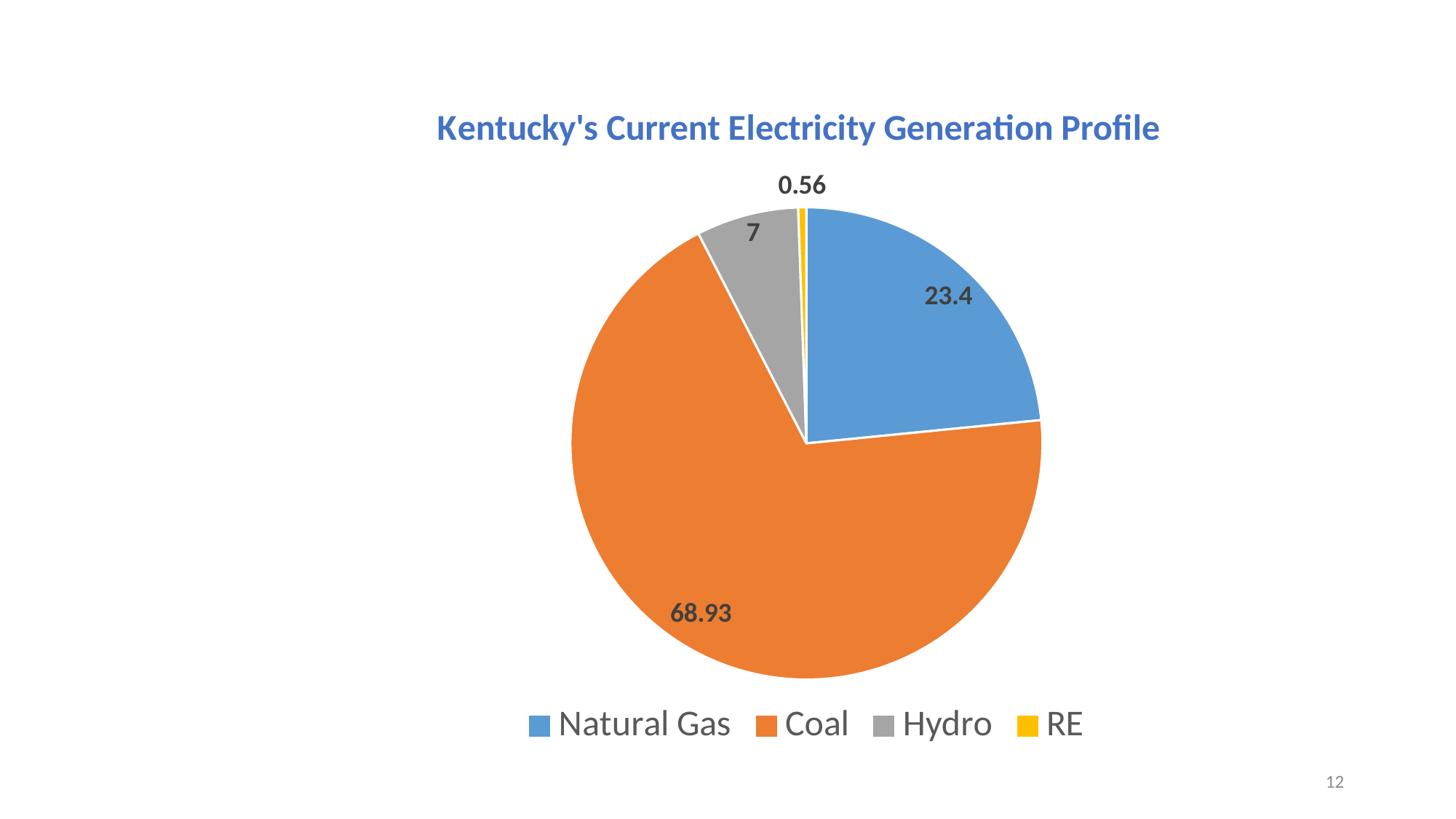
What is the value for Natural Gas? 23.4 Which is larger, the value for Natural Gas or the value for Hydro? Natural Gas Which category has the smallest slice? RE Which category has the largest slice? Coal What is the title of the chart? Kentucky's Current Electricity Generation Profile What is the difference between the values for Hydro and RE? 6.44 What is the difference between the values for Coal and Natural Gas? 45.53 What is the value for Coal? 68.93 What is the value for RE? 0.56 How many categories does the pie chart show? 4 What is the value for Hydro? 7 What kind of chart is shown on the slide? Pie chart